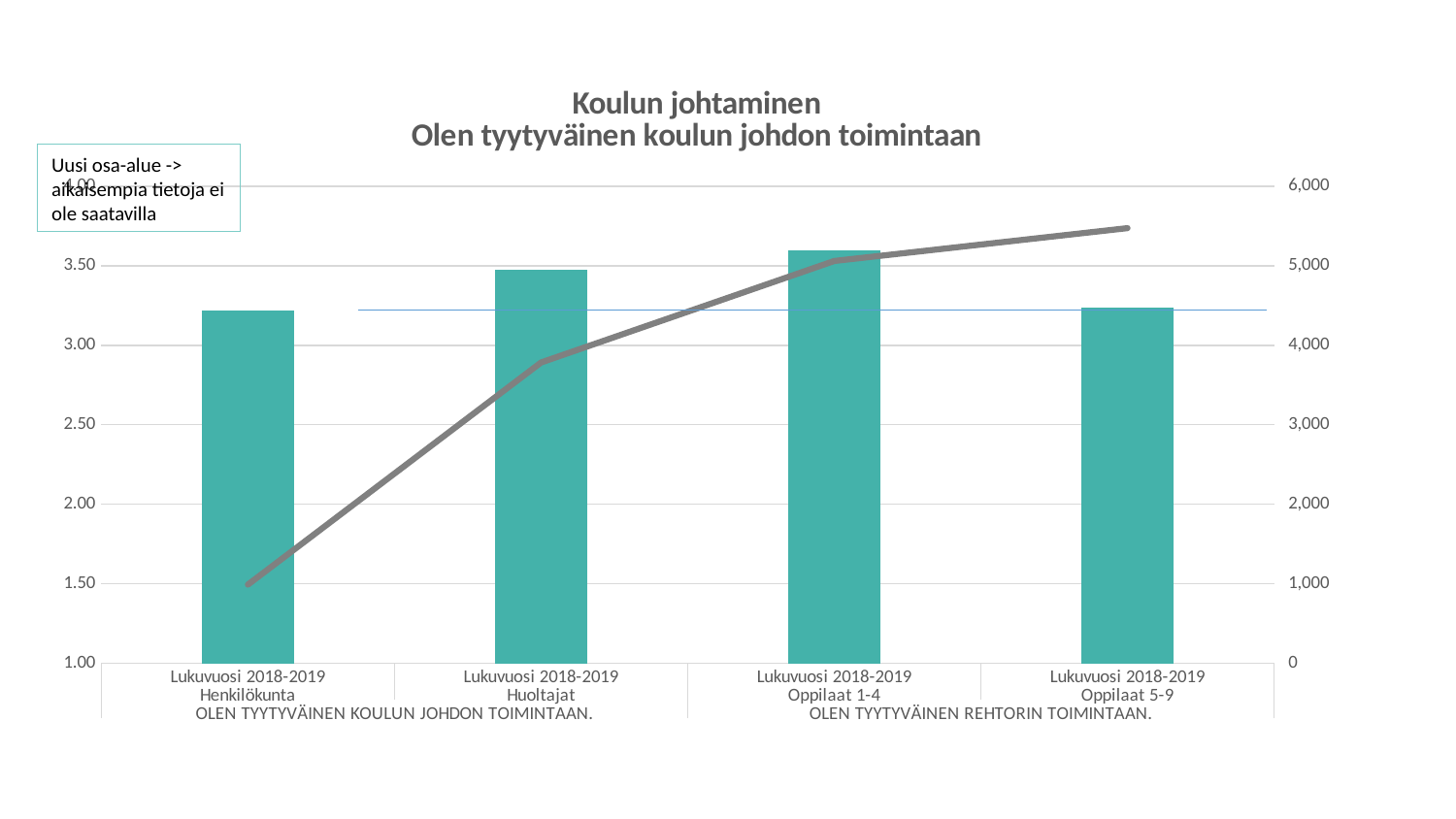
How many bars are plotted in the chart? 4 What is the first line of the chart title? Koulun johtaminen What kind of chart is shown on the slide? A bar chart with a line overlay Which category has the tallest bar? Lukuvuosi 2018-2019 Oppilaat 1-4 Which bar is taller, Lukuvuosi 2018-2019 Huoltajat or Lukuvuosi 2018-2019 Henkilökunta? Lukuvuosi 2018-2019 Huoltajat Is the grey line's value at Lukuvuosi 2018-2019 Henkilökunta greater or less than 2,000 on the right axis? less Is the bar for Lukuvuosi 2018-2019 Henkilökunta greater or less than 3.00 on the left axis? greater Does the grey line rise or fall from left to right across the categories? It rises Is the bar for Lukuvuosi 2018-2019 Huoltajat greater or less than 3.00 on the left axis? greater